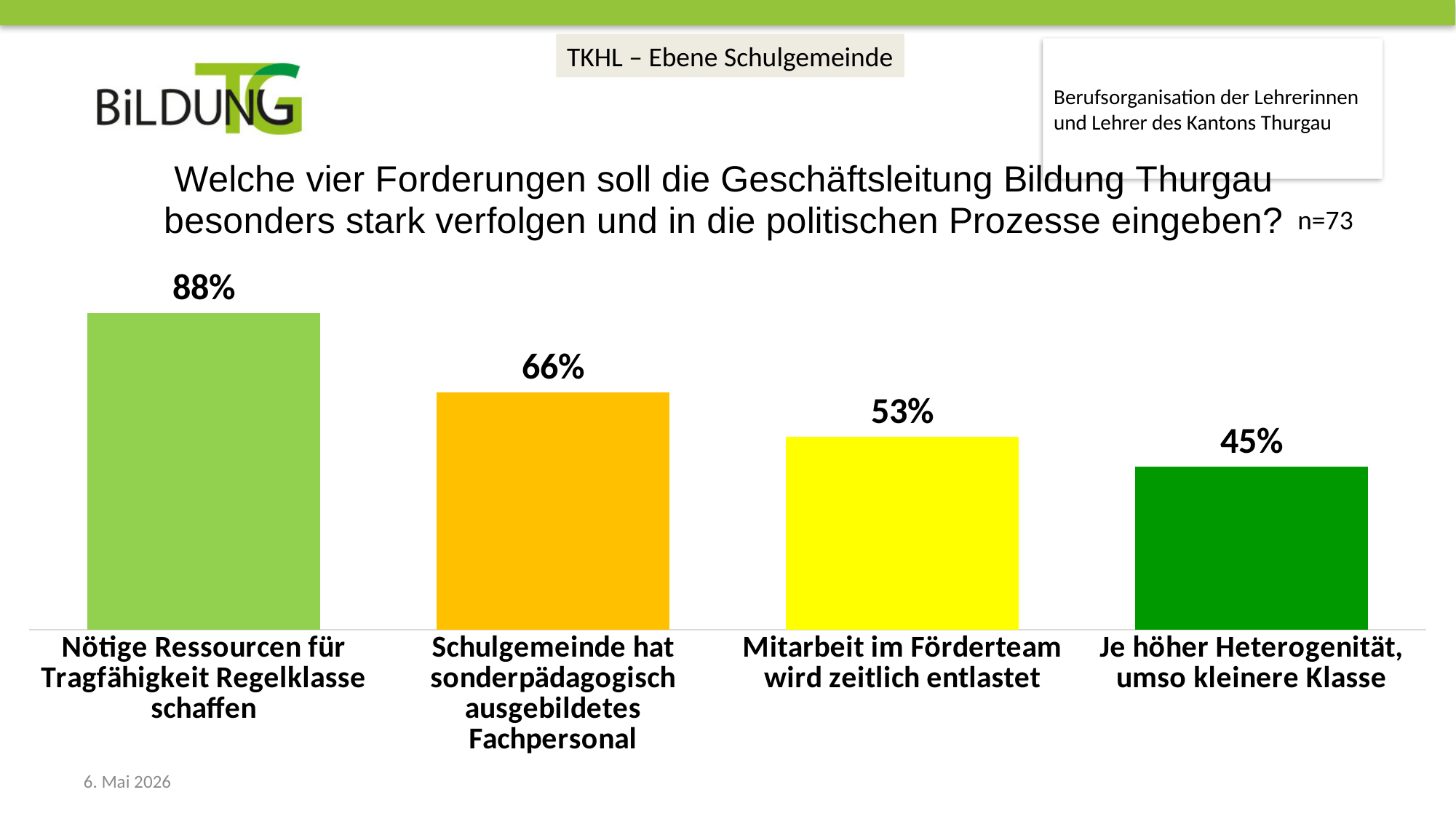
What is the value for "Nötige Ressourcen für Tragfähigkeit Regelklasse schaffen"? 88% What kind of chart is shown on the slide? Bar chart What is the difference between the values for "Schulgemeinde hat sonderpädagogisch ausgebildetes Fachpersonal" and "Mitarbeit im Förderteam wird zeitlich entlastet"? 13% What is the difference between the values for "Nötige Ressourcen für Tragfähigkeit Regelklasse schaffen" and "Je höher Heterogenität, umso kleinere Klasse"? 43% What is the value for "Schulgemeinde hat sonderpädagogisch ausgebildetes Fachpersonal"? 66% Do the values rise or fall from left to right along the x axis? Fall What is the value for "Mitarbeit im Förderteam wird zeitlich entlastet"? 53% Which category has the lowest value? Je höher Heterogenität, umso kleinere Klasse Which is larger: the value for "Mitarbeit im Förderteam wird zeitlich entlastet" or for "Je höher Heterogenität, umso kleinere Klasse"? Mitarbeit im Förderteam wird zeitlich entlastet Which category has the highest value? Nötige Ressourcen für Tragfähigkeit Regelklasse schaffen How many categories are shown in the chart? 4 What is the value for "Je höher Heterogenität, umso kleinere Klasse"? 45%